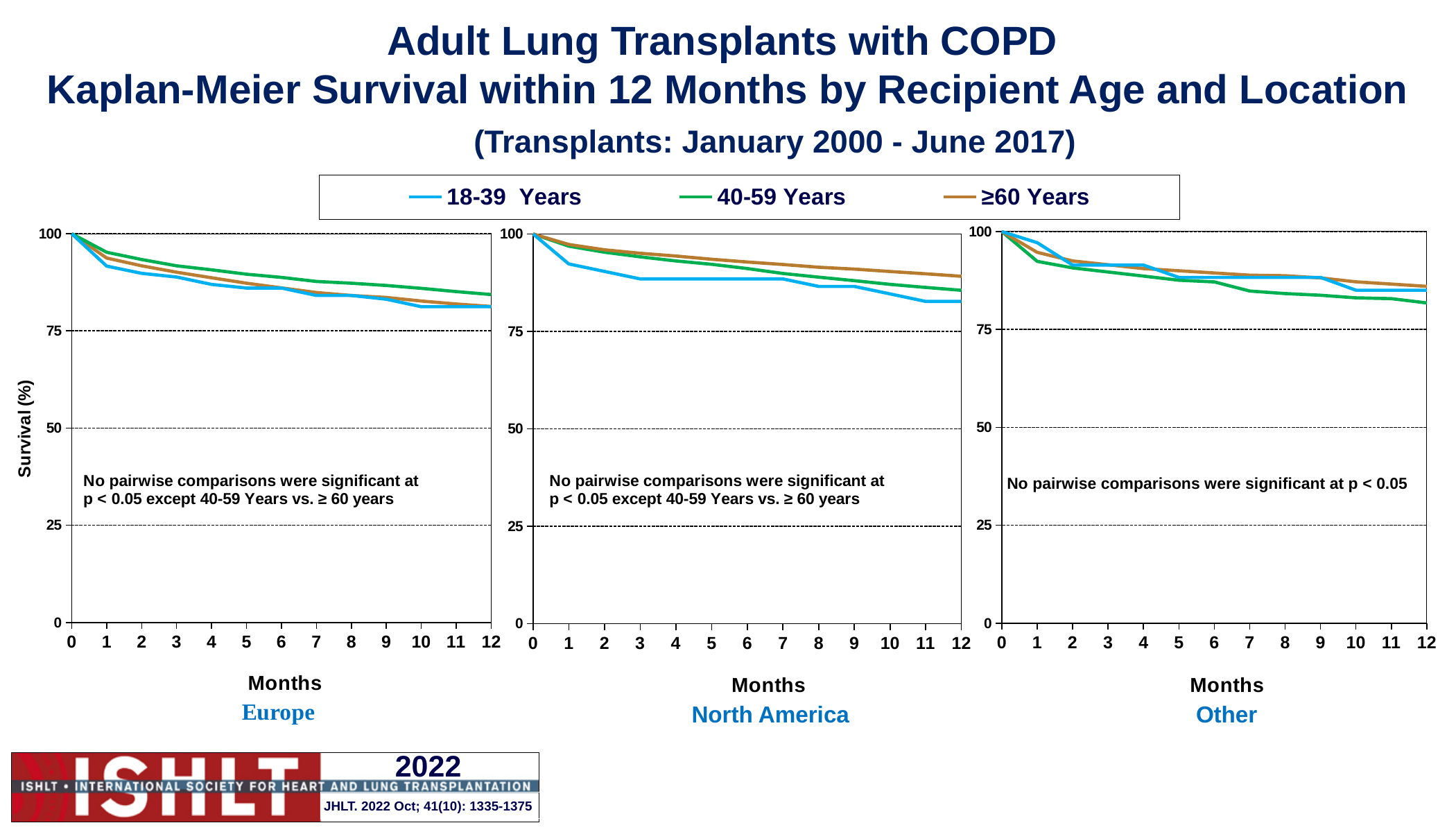
In the Europe chart, do the survival values rise or fall as months increase? fall In the Europe chart, is the value for the 18-39 Years series at month 12 greater or less than 75? greater What kind of chart is the Europe chart? line chart In the North America chart, is the value for the 40-59 Years series at month 12 greater or less than 75? greater In the North America chart, which series has the highest survival at month 12? ≥60 Years In the North America chart, what is the survival value for the 18-39 Years series at month 0? 100 What is the label of the y axis on the Europe chart? Survival (%) In the Other chart, is the value for the ≥60 Years series at month 12 greater or less than 100? less In the North America chart, which is larger at month 6: the ≥60 Years series or the 18-39 Years series? ≥60 Years In the Other chart, which series has the lowest survival at month 12? 40-59 Years In the North America chart, which series has the lowest survival at month 12? 18-39 Years How many series does the legend list? 3